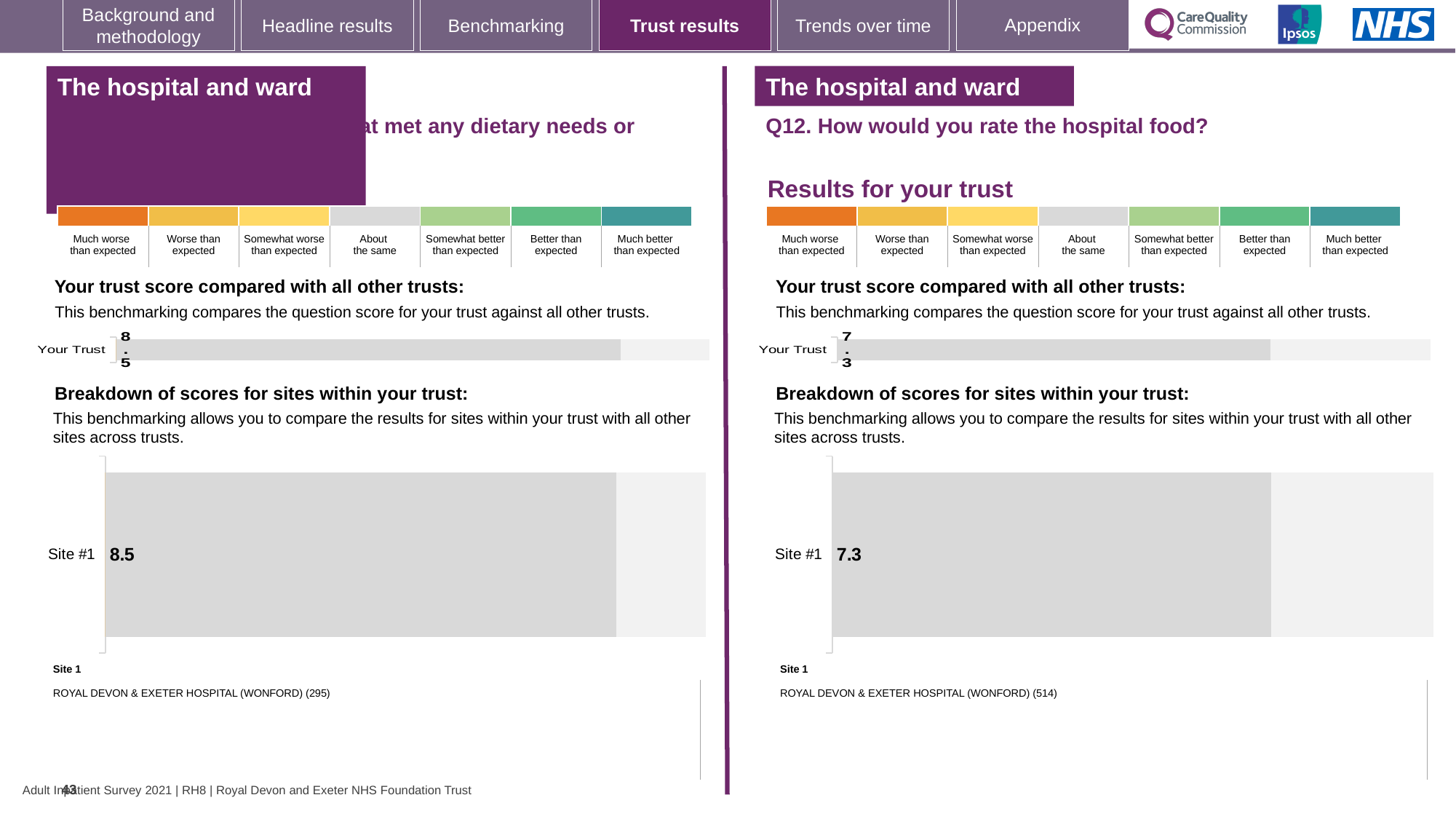
On the left half of the slide, what is the name of Site 1? ROYAL DEVON & EXETER HOSPITAL (WONFORD) (295) On the left half of the slide, what is the score shown for Your Trust? 8.5 On the right half of the slide (Q12), what is the name of Site 1? ROYAL DEVON & EXETER HOSPITAL (WONFORD) (514) On the right half of the slide (Q12), is the Your Trust score the same as the Site #1 score? Yes How many sites are listed in the breakdown of scores on the right half of the slide (Q12)? 1 On the right half of the slide (Q12, hospital food), what is the score shown for Your Trust? 7.3 On the right half of the slide (Q12, hospital food), what is the score shown for Site #1? 7.3 What kind of chart is used to show the Site #1 score on the right half of the slide (Q12)? Bar chart On the left half of the slide, what is the score shown for Site #1? 8.5 What is the difference between the Site #1 score on the left half of the slide and the Site #1 score on the right half (Q12)? 1.2 Which is larger: the Site #1 score on the left half of the slide or the Site #1 score on the right half (Q12)? Left half (8.5) How many sites are listed in the breakdown of scores on the left half of the slide? 1